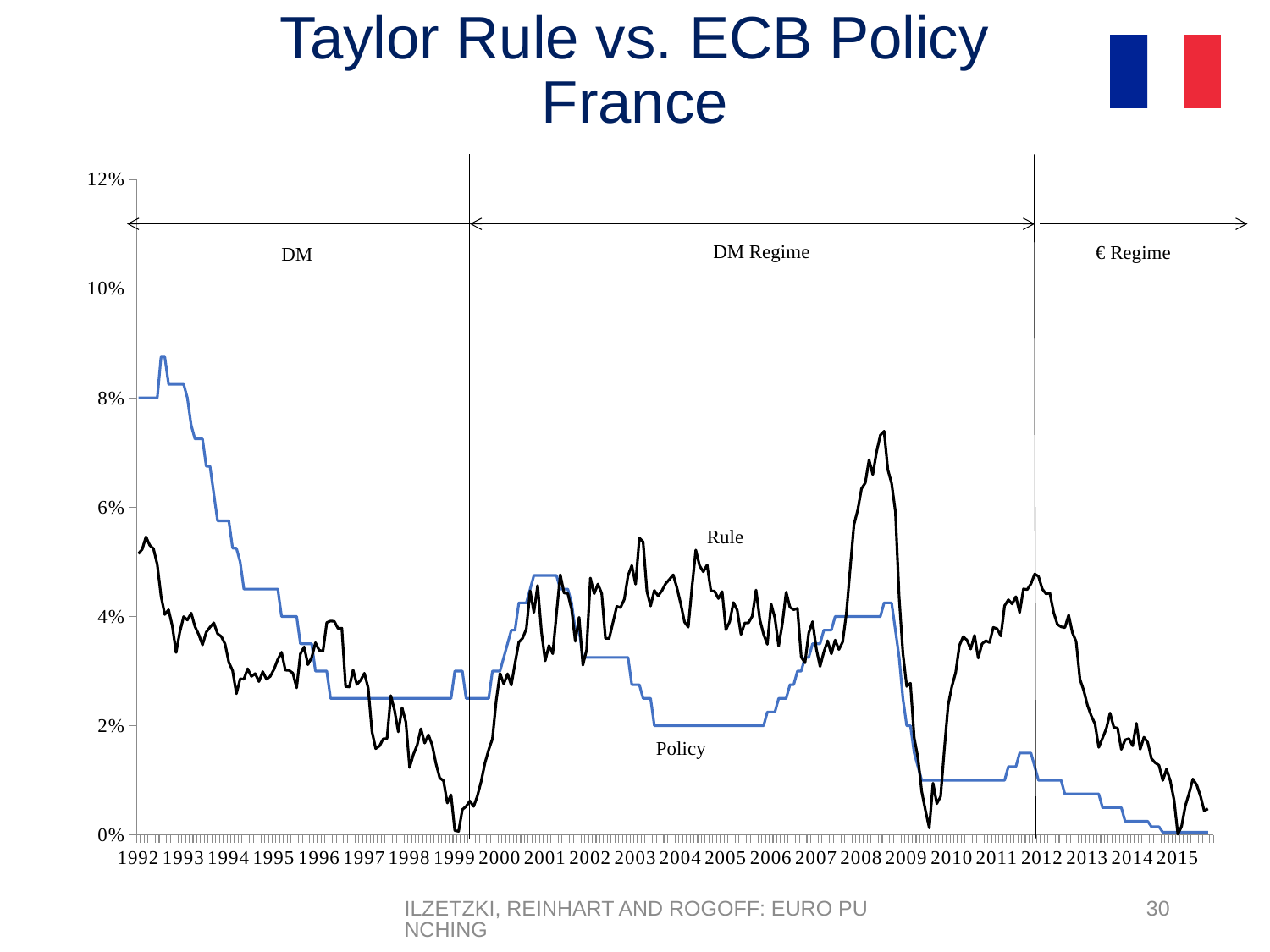
What colour is the Policy line? blue Is the Policy value at the end of 2015 greater or less than 2%? less Is the Policy value during 2004 greater or less than 4%? less Does the Policy line rise or fall between 1992 and 1999? fall Is the Policy value at the start of 1992 greater or less than 6%? greater What kind of chart is shown on the slide? line chart Which series reaches the highest value anywhere on the chart? Policy In 2008, which series is higher, Rule or Policy? Rule What are the names of the two series labelled on the chart? Rule and Policy How many data series are plotted on the chart? 2 In 1993, which series is higher, Rule or Policy? Policy